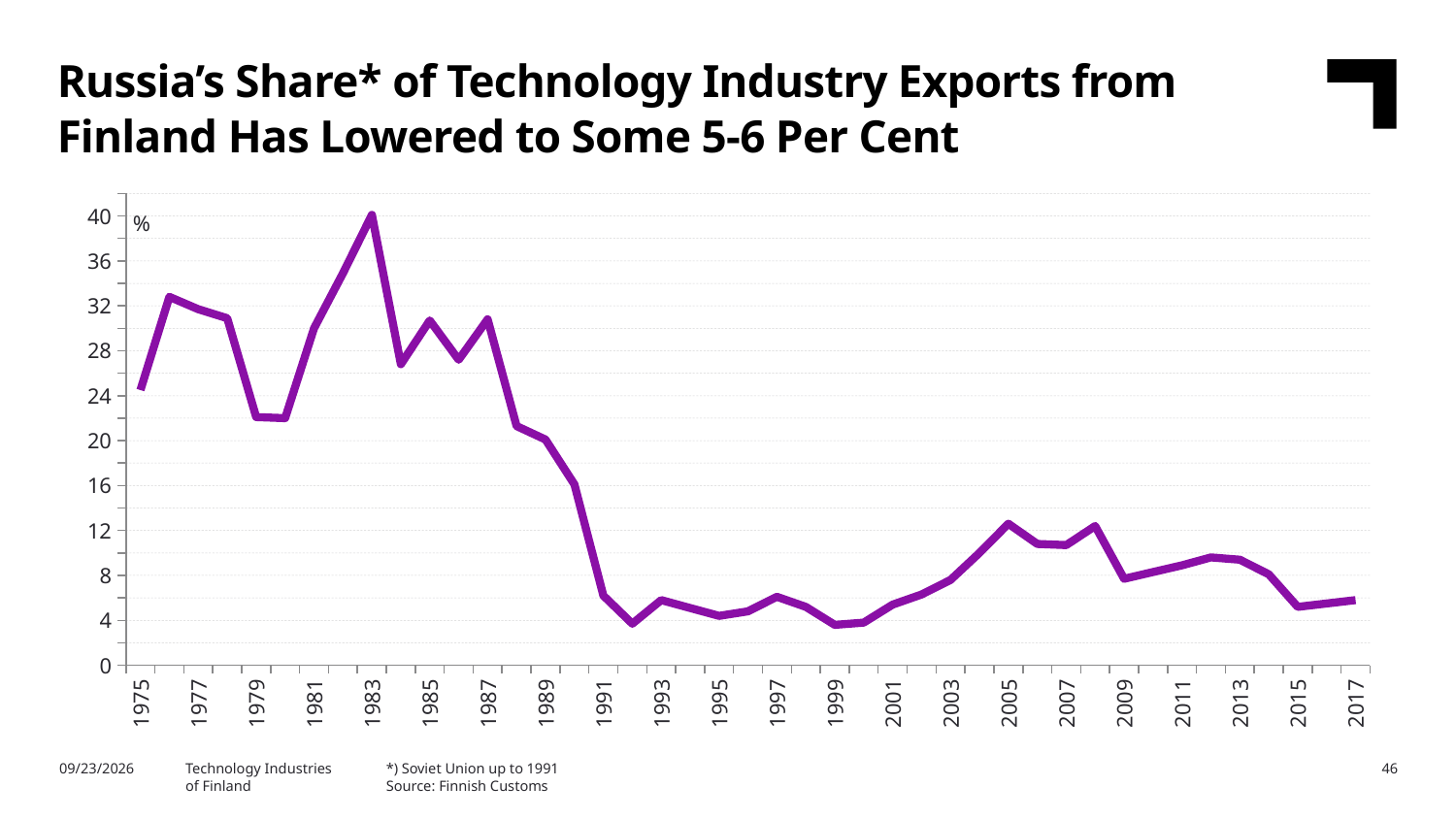
Which year has the larger value, 2005 or 2015? 2005 Is the value for 1975 greater or less than 28? less Is the value for 1991 greater or less than 8? less Is the value for 1983 greater or less than 36? greater Which year has the larger value, 1983 or 1985? 1983 Which year has the larger value, 1975 or 2017? 1975 What kind of chart is shown on the slide? line chart Overall, does the line rise or fall from 1975 to 2017? fall What unit is shown at the top of the y axis? % In which year does Russia's share of technology industry exports from Finland reach its highest value? 1983